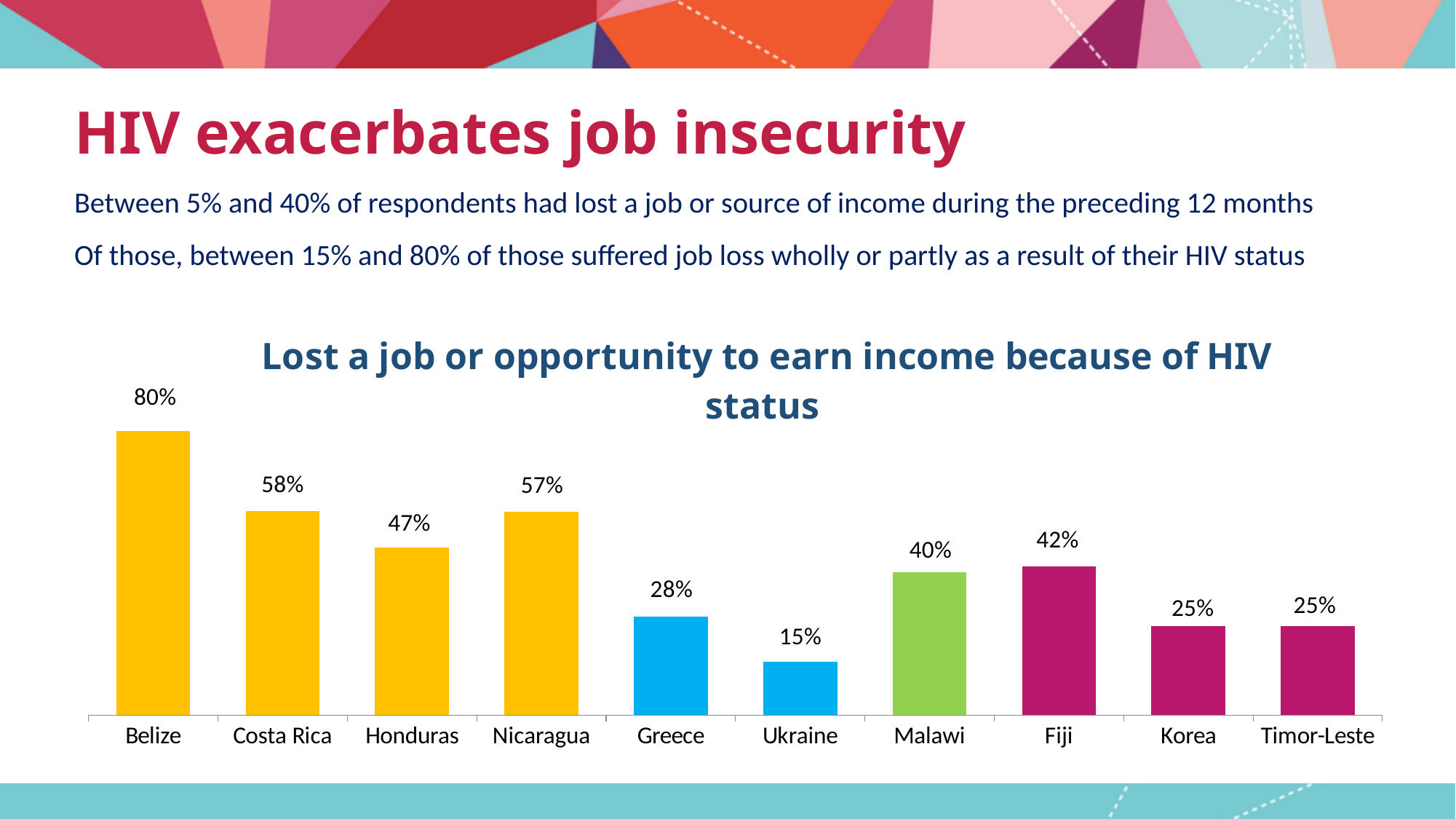
Which is larger, the value for Fiji or the value for Malawi? Fiji What is the value for Ukraine? 15% What kind of chart is shown on the slide? Bar chart What is the title of the chart? Lost a job or opportunity to earn income because of HIV status What is the value for Belize? 80% What is the value for Malawi? 40% Which country has the lowest value? Ukraine How many countries are shown in the chart? 10 What is the difference between the values for Costa Rica and Honduras? 11% Which is larger, the value for Nicaragua or the value for Greece? Nicaragua Which country has the highest value? Belize What is the difference between the values for Belize and Greece? 52%